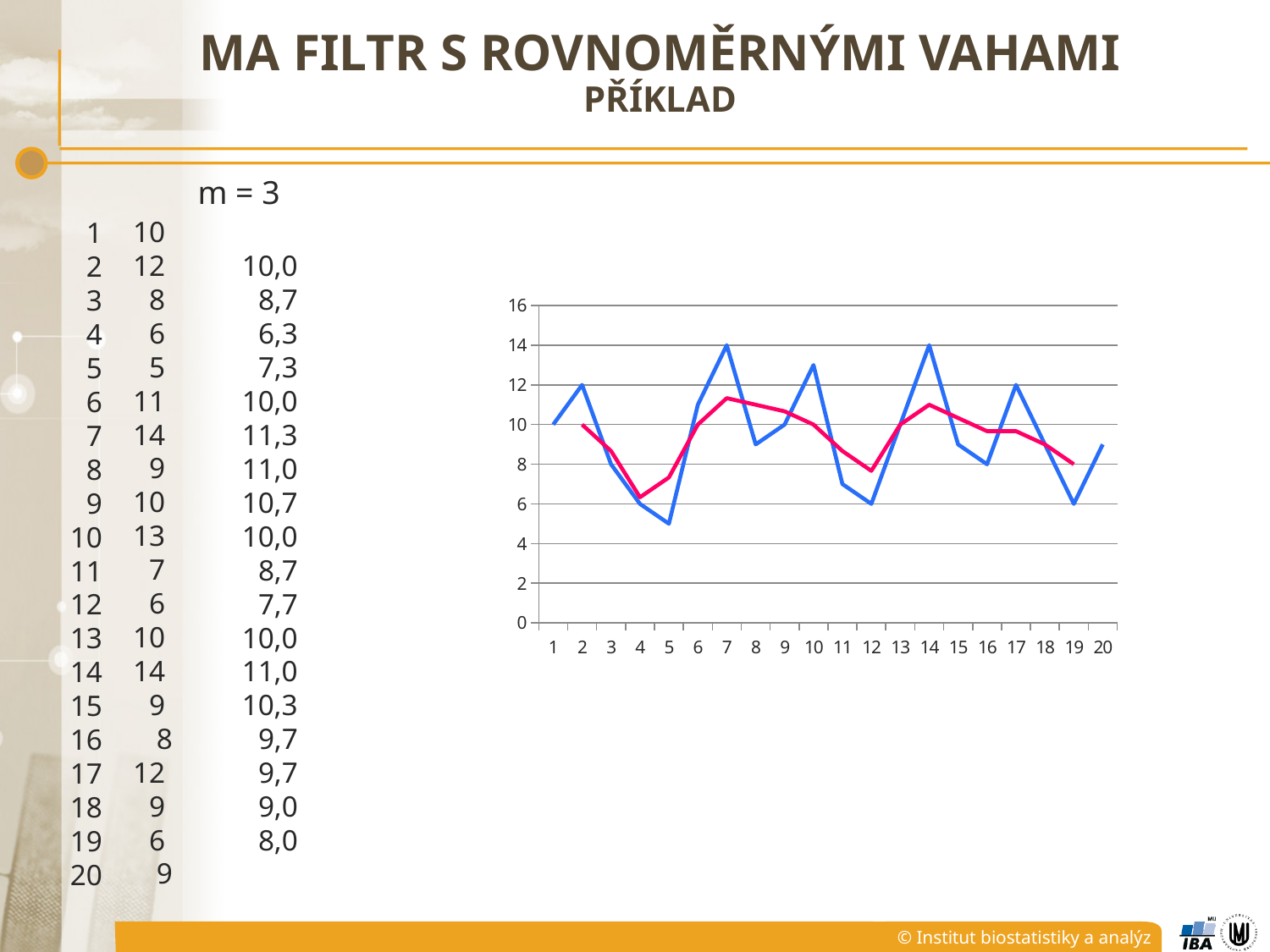
Which is larger, the blue line value at x = 7 or at x = 8? x = 7 How many points are labelled along the x axis of the chart? 20 How many lines are plotted in the chart? 2 What is the value of the blue line at x = 19? 6 At which x value does the blue line reach its lowest point? 5 Does the blue line rise or fall from x = 2 to x = 5? fall What is the highest value reached by the blue line? 14 What is the value of the blue line at x = 2? 12 What is the difference between the blue line values at x = 7 and x = 12? 8 Is the value of the blue line at x = 10 greater or less than 12? greater Is the value of the red line at x = 7 greater or less than 10? greater What kind of chart is shown on the slide? line chart